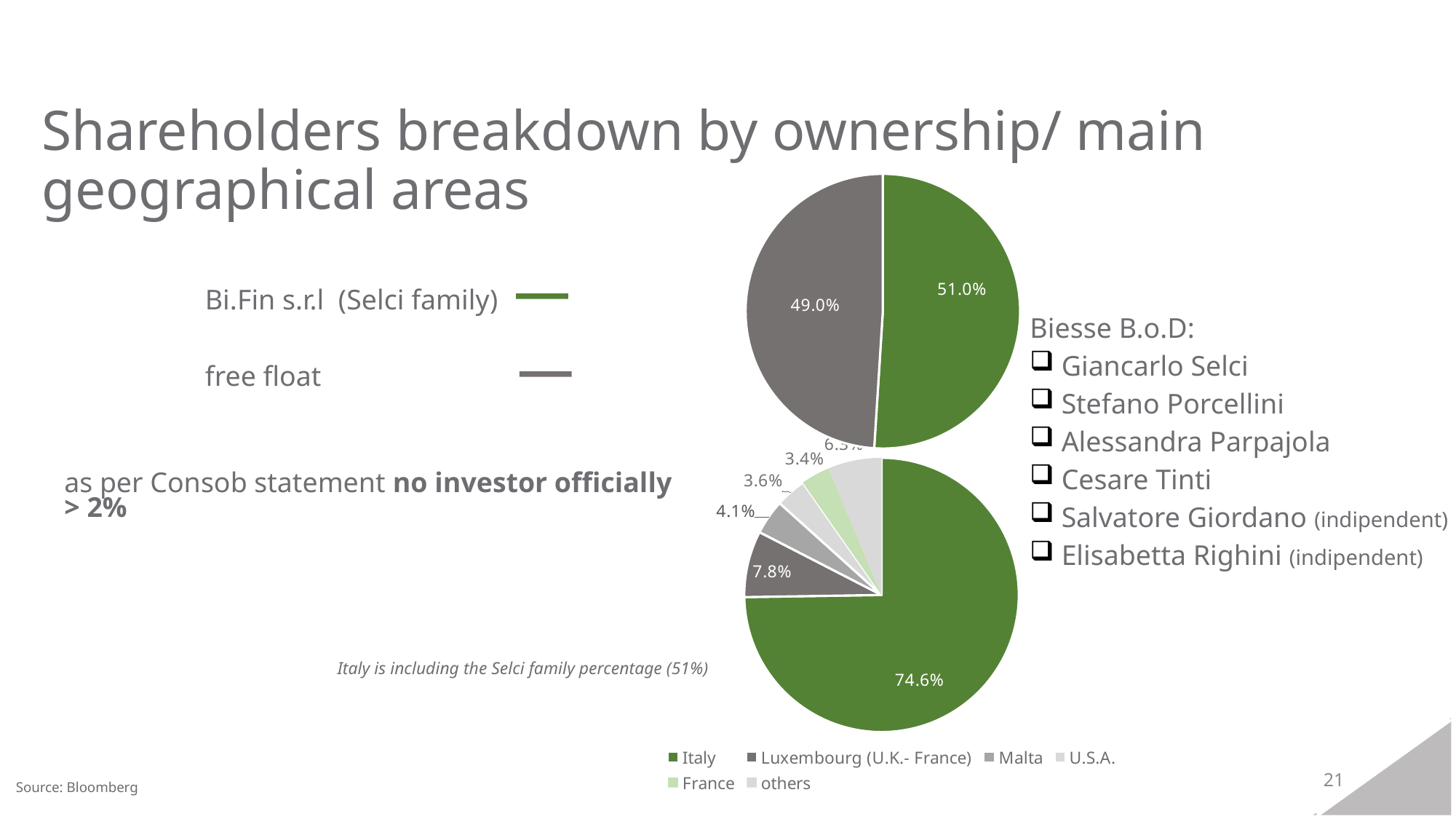
In the bottom pie chart (geographical areas), what is the value for France? 3.4% In the top pie chart, what share is the free float? 49.0% In the top pie chart, what share is held by Bi.Fin s.r.l (Selci family)? 51.0% In the bottom pie chart (geographical areas), what is the difference between Italy and Luxembourg (U.K.- France)? 66.8% In the bottom pie chart (geographical areas), which category has the largest share? Italy In the top pie chart, which is larger: Bi.Fin s.r.l (Selci family) or free float? Bi.Fin s.r.l (Selci family) In the bottom pie chart (geographical areas), what is the value for Italy? 74.6% In the bottom pie chart (geographical areas), what is the value for Malta? 4.1% In the top pie chart, what is the difference between the Bi.Fin s.r.l (Selci family) share and the free float share? 2.0% What type of chart is used to show the shareholders breakdown on this slide? Pie chart How many entries does the legend of the bottom pie chart (geographical areas) list? 6 In the bottom pie chart (geographical areas), what is the value for Luxembourg (U.K.- France)? 7.8%